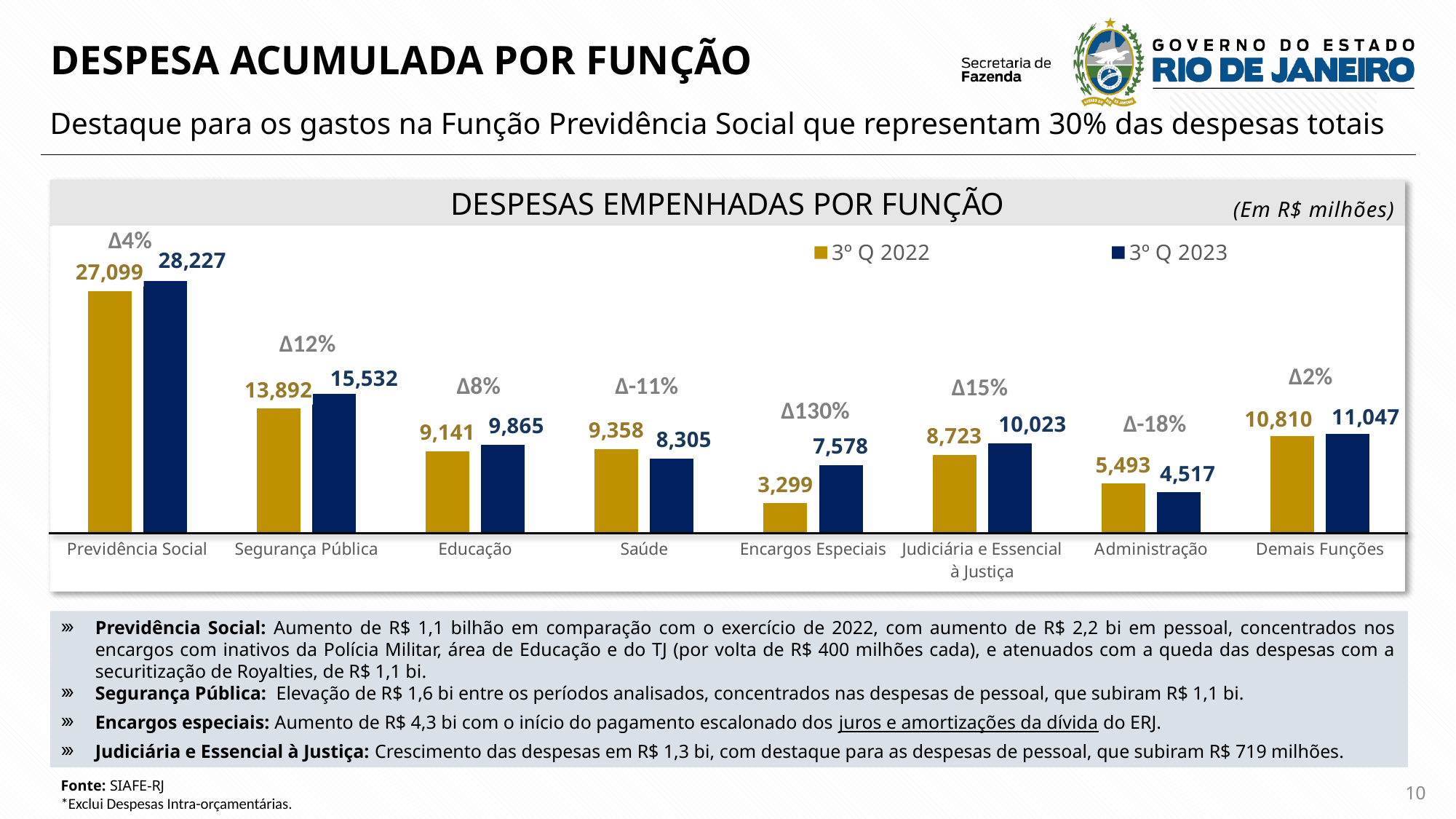
What kind of chart is shown on the slide? Bar chart What is the title of the chart? DESPESAS EMPENHADAS POR FUNÇÃO How many series does the legend list? 2 How many categories are shown on the x axis? 8 Which category has the highest value in the 3º Q 2023 series? Previdência Social What is the difference between the 3º Q 2023 and 3º Q 2022 values for Segurança Pública? 1,640 What is the value for Saúde in the 3º Q 2023 series? 8,305 Which is larger for Administração: the 3º Q 2022 value or the 3º Q 2023 value? 3º Q 2022 What is the value for Encargos Especiais in the 3º Q 2022 series? 3,299 What percentage change is shown above the Encargos Especiais bars? Δ130% Which category has the lowest value in the 3º Q 2022 series? Encargos Especiais What is the value for Previdência Social in the 3º Q 2023 series? 28,227